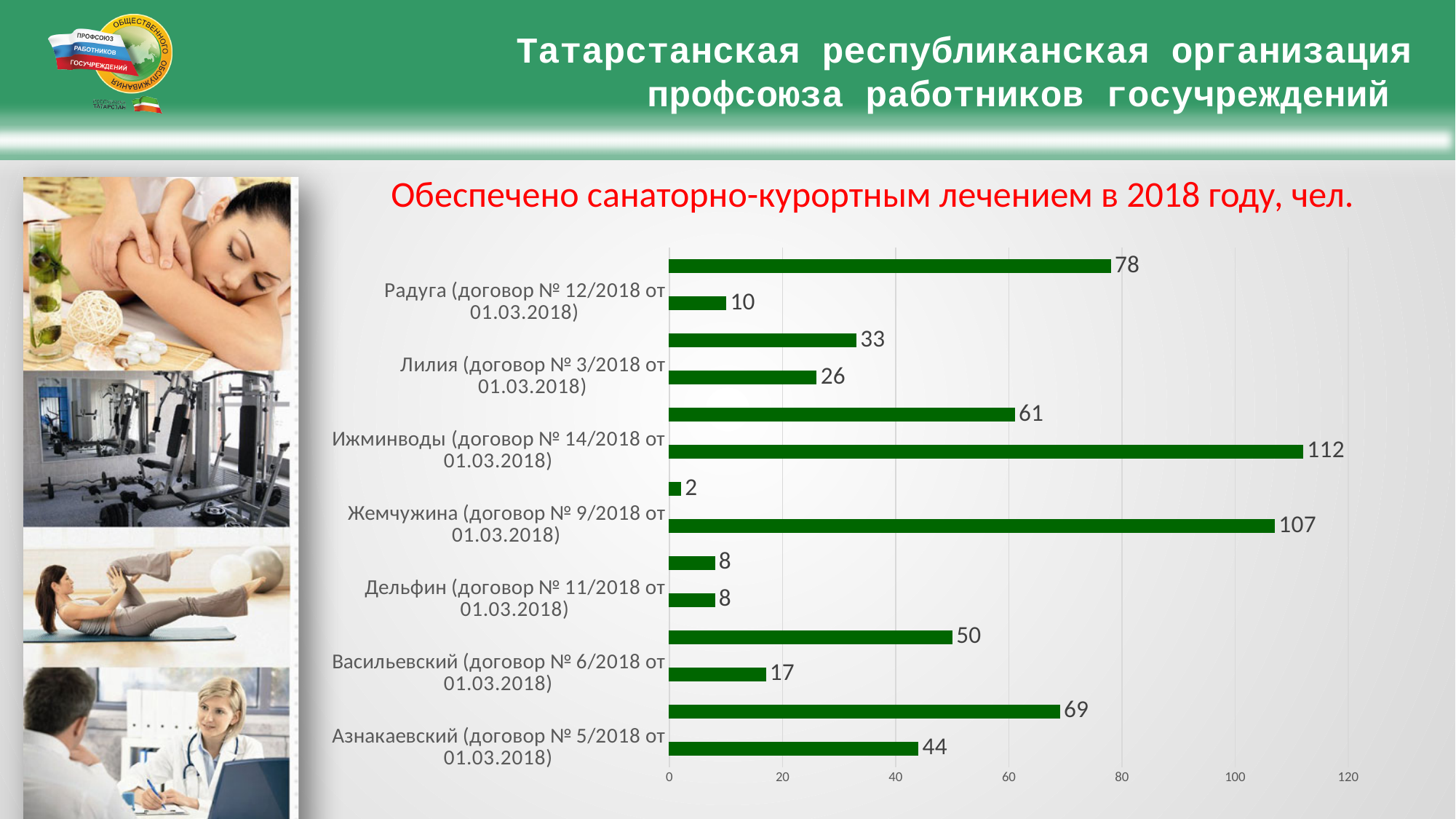
How many categories (sanatoriums) are listed on the vertical axis of the chart? 7 What is the value of the lower bar for Жемчужина (договор № 9/2018 от 01.03.2018)? 107 What is the maximum value shown on the horizontal axis of the chart? 120 What is the title of the chart? Обеспечено санаторно-курортным лечением в 2018 году, чел. What kind of chart is shown on the slide? bar chart What is the value of the lower bar for Ижминводы (договор № 14/2018 от 01.03.2018)? 112 Which category has the highest single bar value in the chart? Ижминводы (договор № 14/2018 от 01.03.2018)